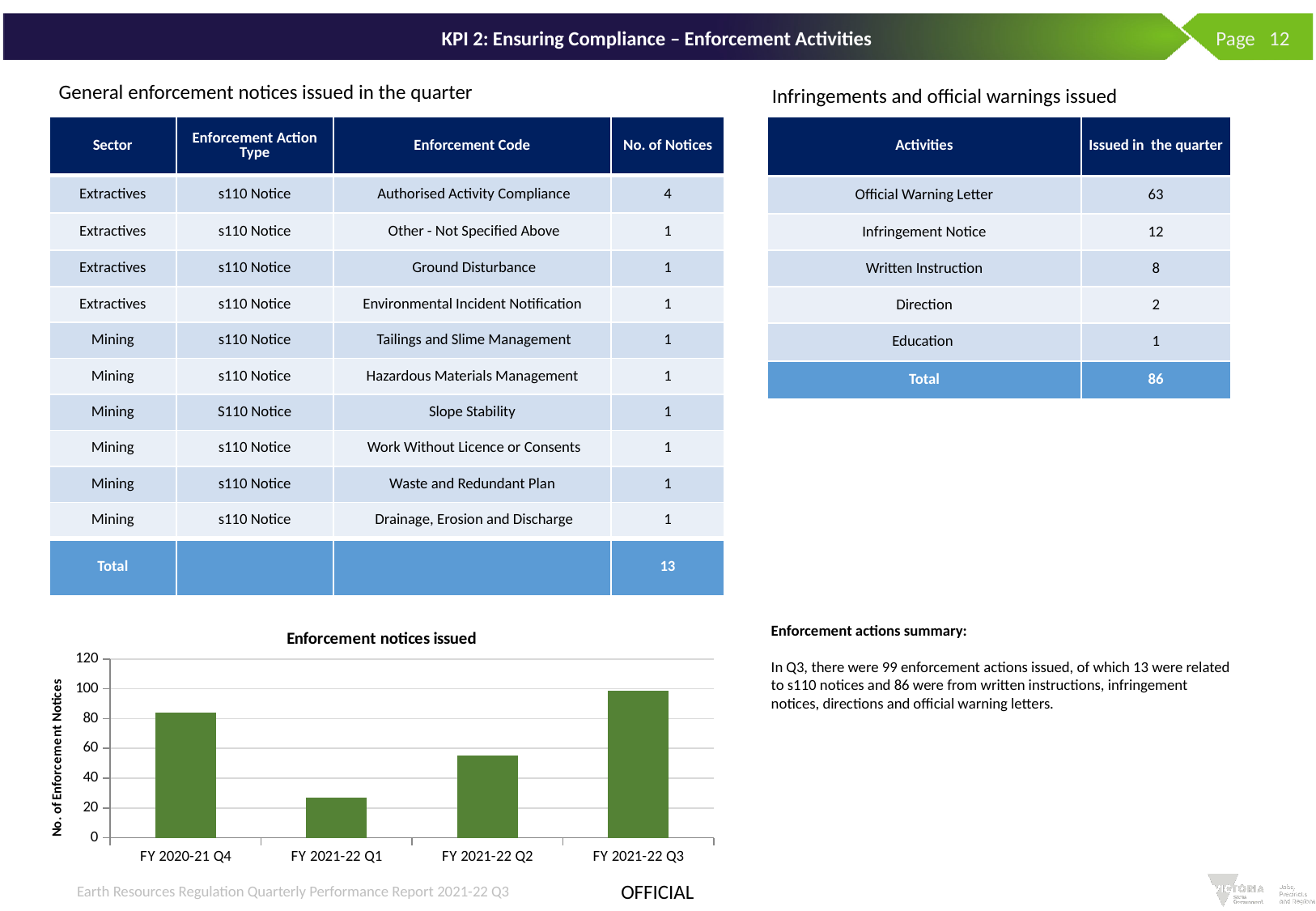
How many quarters are shown on the x axis of the "Enforcement notices issued" chart? 4 In the "Enforcement notices issued" chart, is the value for FY 2021-22 Q1 greater or less than 40? less What is the y-axis label of the "Enforcement notices issued" chart? No. of Enforcement Notices In the "Enforcement notices issued" chart, which quarter has the highest number of enforcement notices? FY 2021-22 Q3 In the "Enforcement notices issued" chart, is the value for FY 2021-22 Q3 greater or less than 80? greater In the "Enforcement notices issued" chart, do the values rise or fall from FY 2021-22 Q1 to FY 2021-22 Q3? rise In the "Enforcement notices issued" chart, which quarter has the lowest number of enforcement notices? FY 2021-22 Q1 In the "Enforcement notices issued" chart, is the value for FY 2020-21 Q4 greater or less than 100? less What kind of chart is the "Enforcement notices issued" chart? bar chart What is the title of the bar chart on the slide? Enforcement notices issued In the "Enforcement notices issued" chart, which is larger: the value for FY 2020-21 Q4 or FY 2021-22 Q2? FY 2020-21 Q4